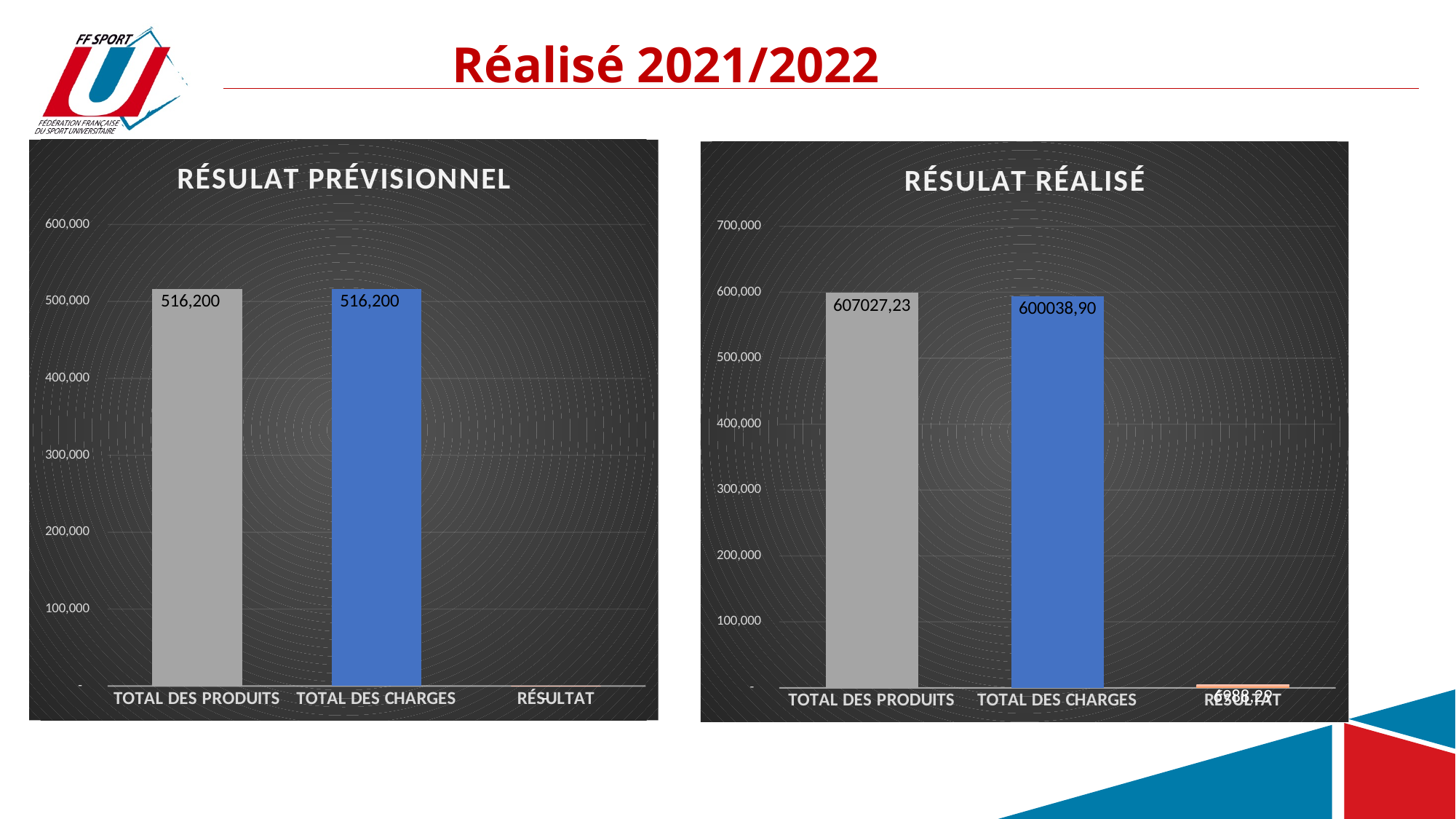
In the RÉSULTAT RÉALISÉ chart, what is the value for TOTAL DES PRODUITS? 607027,23 How many categories are shown on the x axis of the RÉSULTAT RÉALISÉ chart? 3 In the RÉSULTAT RÉALISÉ chart, which is larger: TOTAL DES PRODUITS or TOTAL DES CHARGES? TOTAL DES PRODUITS In the RÉSULTAT RÉALISÉ chart, which category has the lowest value? RÉSULTAT In the RÉSULTAT RÉALISÉ chart, what is the difference between TOTAL DES PRODUITS and TOTAL DES CHARGES? 6988,33 In the RÉSULTAT PRÉVISIONNEL chart, what is the value for TOTAL DES CHARGES? 516,200 What is the title of the chart on the right side of the slide? RÉSULAT RÉALISÉ In the RÉSULTAT PRÉVISIONNEL chart, what is the value for TOTAL DES PRODUITS? 516,200 What kind of chart is the RÉSULTAT PRÉVISIONNEL chart? Bar chart In the RÉSULTAT PRÉVISIONNEL chart, is the value for TOTAL DES CHARGES greater or less than 400,000? greater In the RÉSULTAT RÉALISÉ chart, what is the value for TOTAL DES CHARGES? 600038,90 In the RÉSULTAT RÉALISÉ chart, which category has the highest value? TOTAL DES PRODUITS